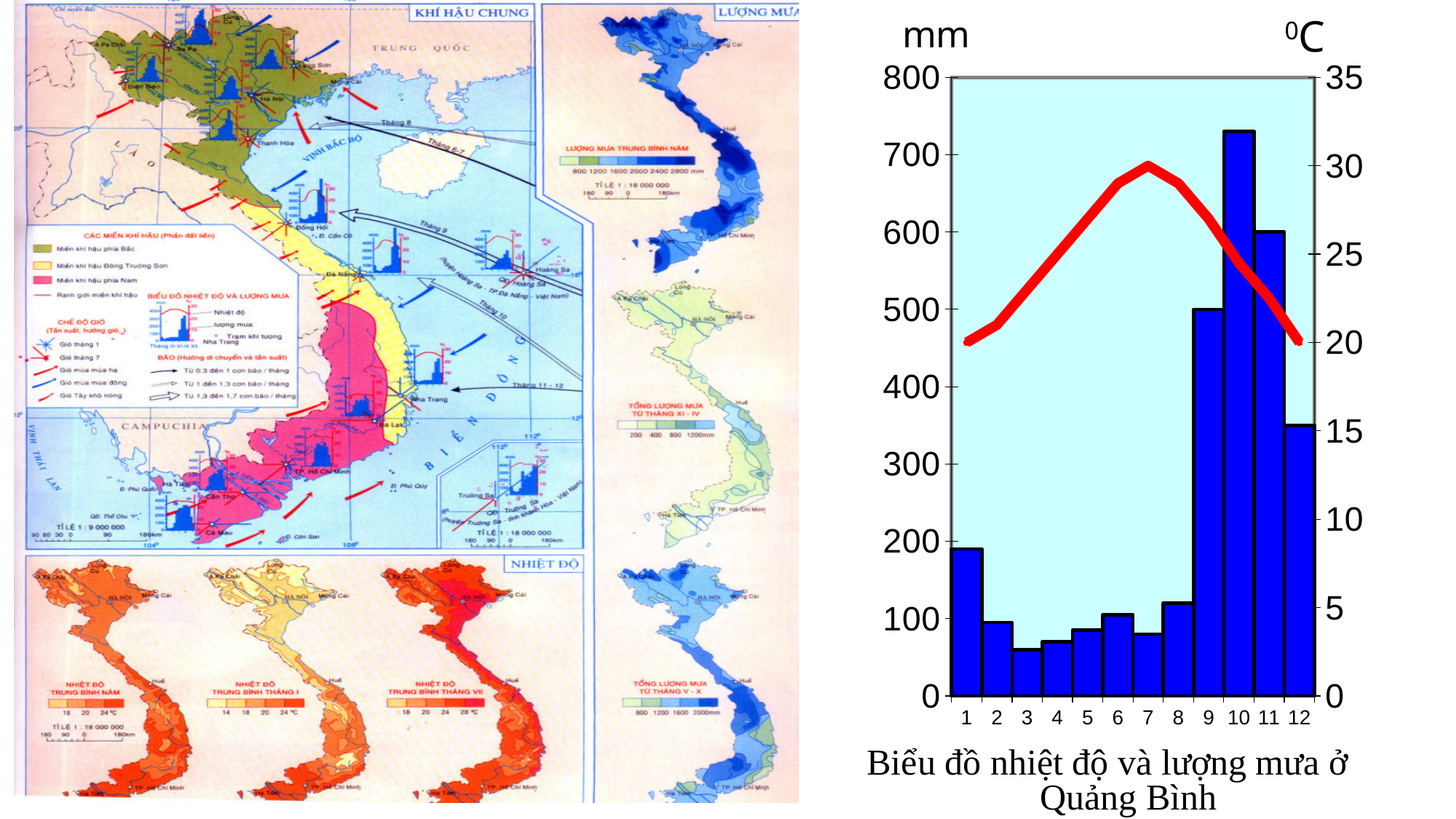
In the chart on the right, how many months are shown on the x axis? 12 In the chart on the right, is the temperature in month 1 greater or less than 25 °C? less In the chart on the right, which month has the larger rainfall bar, month 10 or month 11? 10 In the chart on the right, which month has the highest rainfall bar? 10 What is the title of the chart on the right? Biểu đồ nhiệt độ và lượng mưa ở Quảng Bình In the chart on the right, is the rainfall value for month 9 greater or less than 400? greater In the chart on the right, is the temperature in month 7 greater or less than 25 °C? greater In the chart on the right, how does the temperature line change from month 1 to month 7? It rises In the chart on the right, which month has the larger rainfall bar, month 9 or month 12? 9